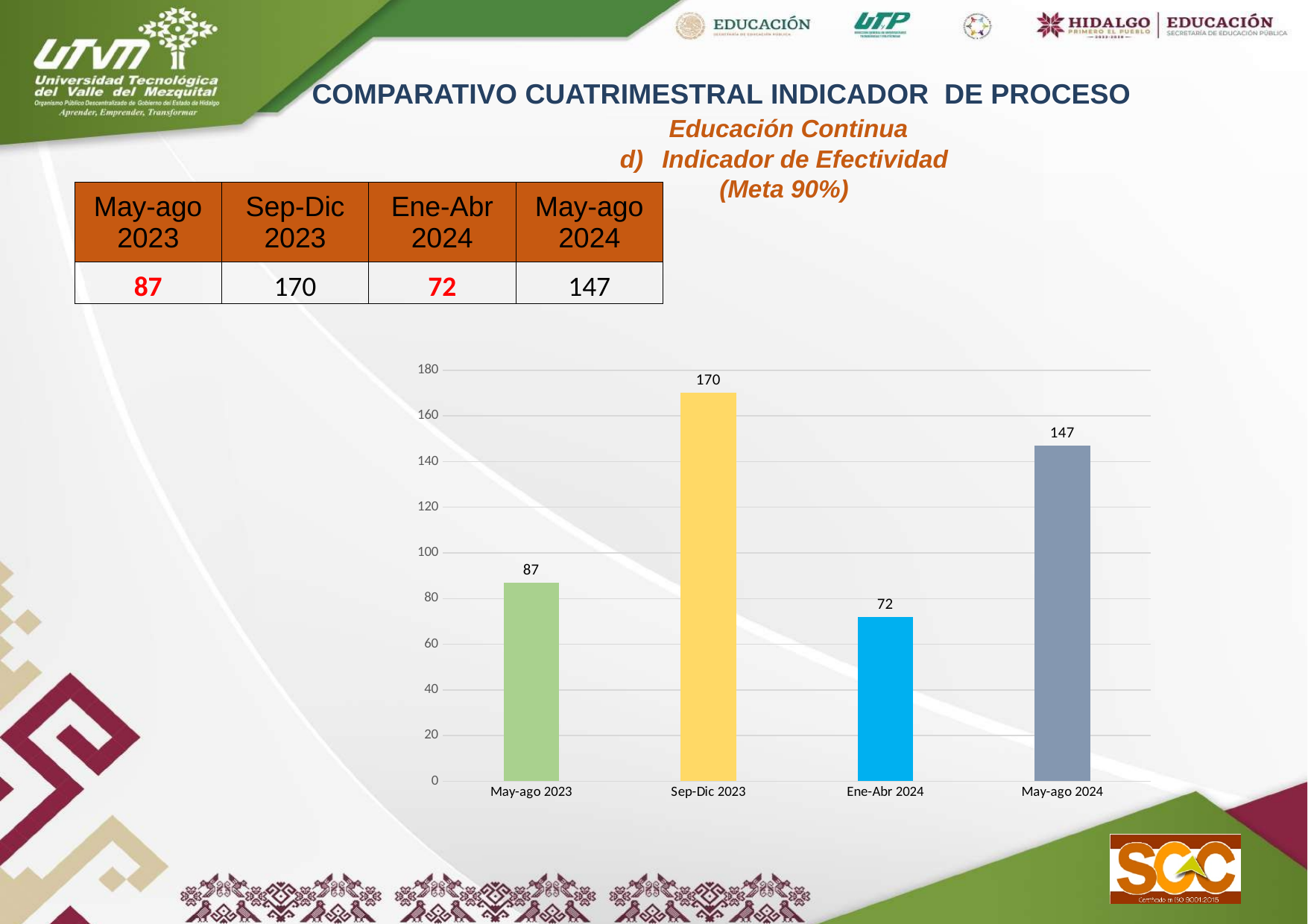
What kind of chart is shown on the slide? Bar chart What colour is the bar for Sep-Dic 2023? Yellow Which is larger, the value for May-ago 2023 or the value for May-ago 2024? May-ago 2024 What is the value for May-ago 2023? 87 Which period has the lowest value? Ene-Abr 2024 What is the difference between the values for May-ago 2023 and Ene-Abr 2024? 15 What is the value for Sep-Dic 2023? 170 Which period has the highest value? Sep-Dic 2023 What is the value for May-ago 2024? 147 What is the value for Ene-Abr 2024? 72 What is the difference between the values for Sep-Dic 2023 and May-ago 2024? 23 How many periods are shown on the x axis of the chart? 4